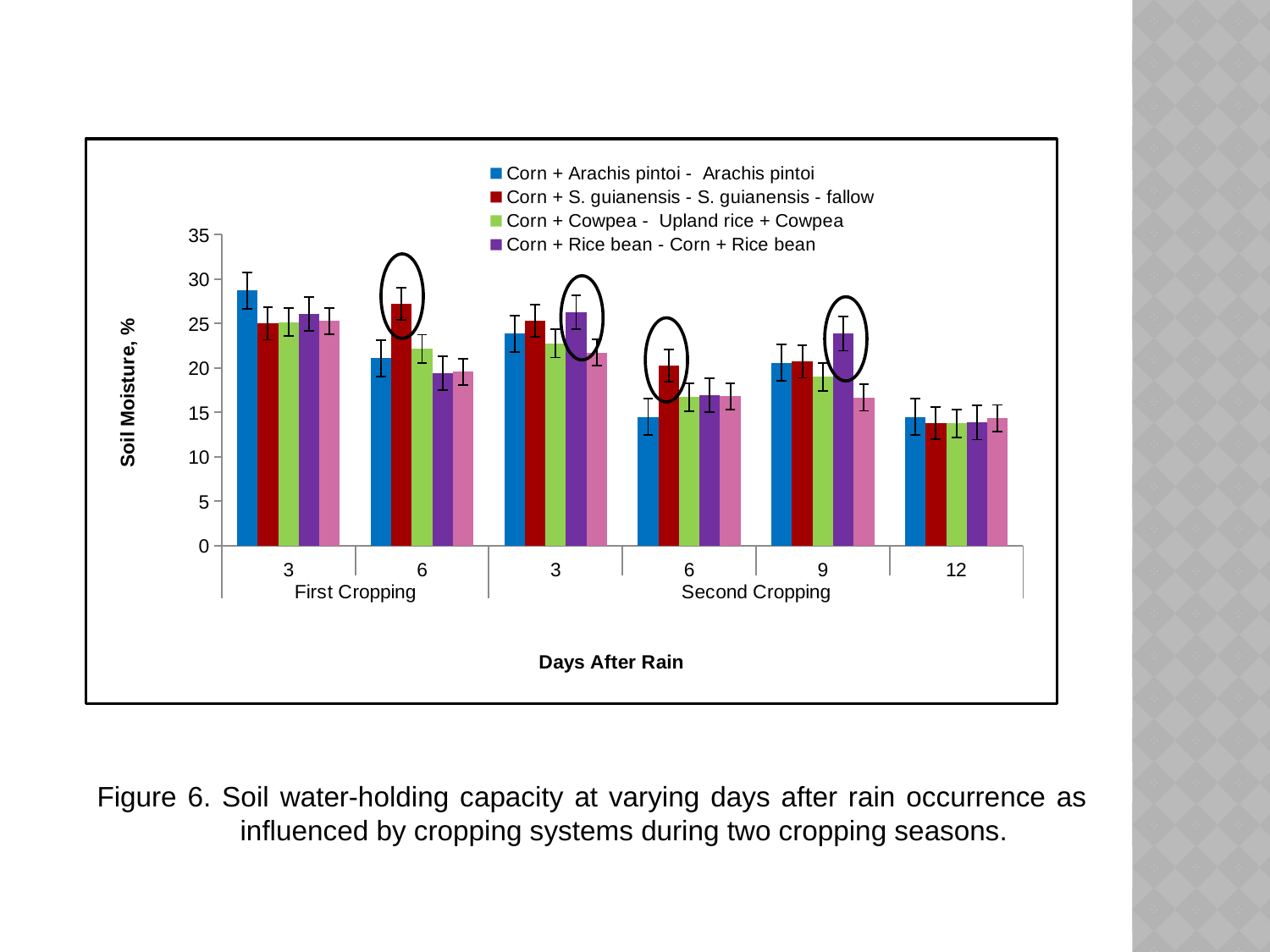
How many series does the legend list? 4 What kind of chart is shown on the slide? Bar chart What is the title of the y axis? Soil Moisture, % Is the value for Corn + Rice bean at 9 days in Second Cropping greater or less than 20? greater Which series has the highest value at 6 days in First Cropping? Corn + S. guianensis - S. guianensis - fallow Which series has the lowest value at 6 days in Second Cropping? Corn + Arachis pintoi - Arachis pintoi Is the value for Corn + Arachis pintoi at 12 days in Second Cropping greater or less than 20? less Which series has the highest value at 3 days in First Cropping? Corn + Arachis pintoi - Arachis pintoi For Corn + Arachis pintoi in First Cropping, is the value larger at 3 days or at 6 days? 3 days What is the title of the x axis? Days After Rain How many day-after-rain groups are plotted along the x axis? 6 Is the value for Corn + Arachis pintoi at 3 days in First Cropping greater or less than 25? greater